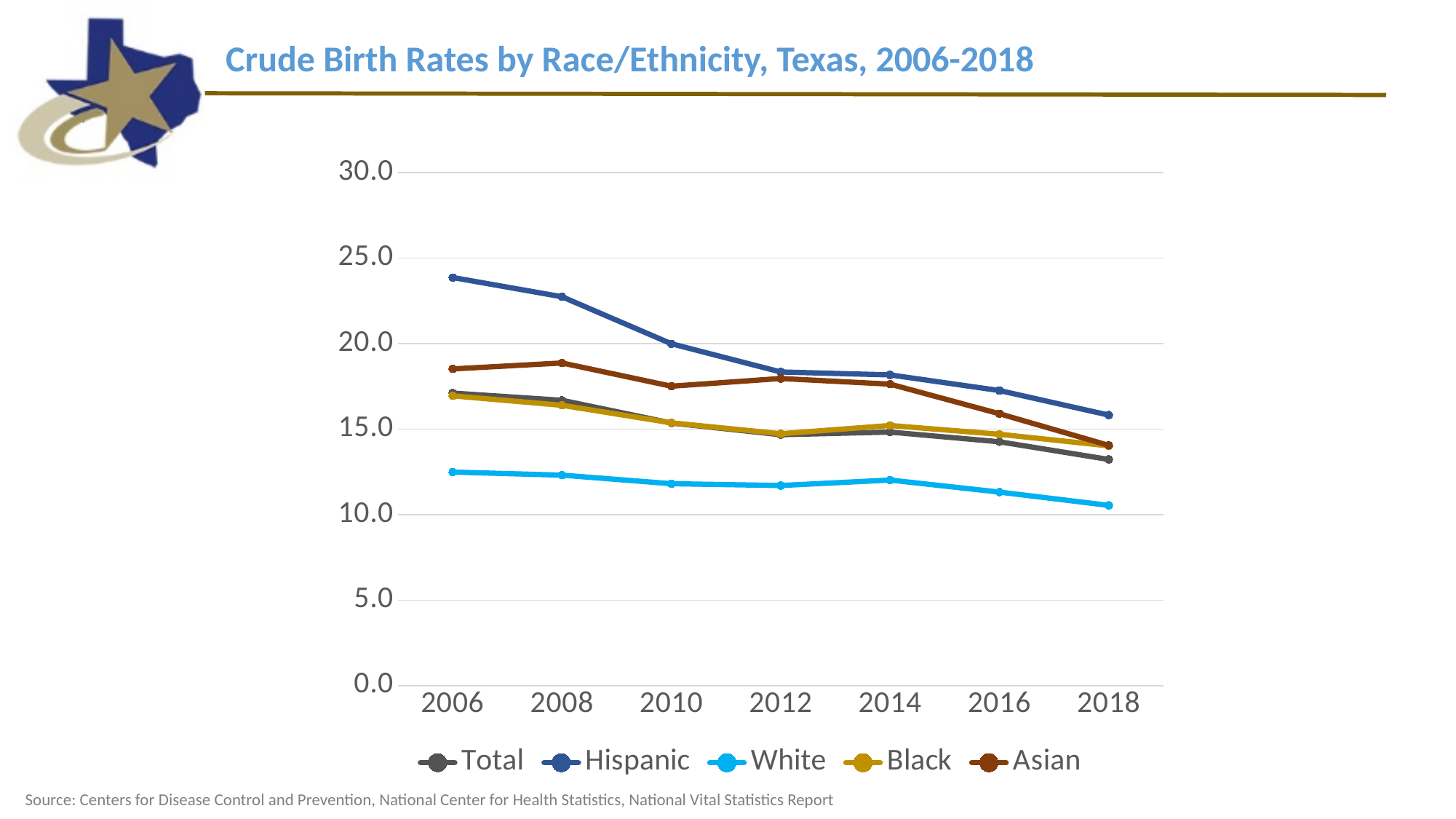
What kind of chart is shown on the slide? line chart Which race/ethnicity group has the lowest crude birth rate in 2018? White Is the Hispanic crude birth rate in 2018 greater or less than 20.0? less Which race/ethnicity group has the highest crude birth rate in 2006? Hispanic Is the Total crude birth rate in 2018 greater or less than 15.0? less Is the Hispanic crude birth rate in 2006 greater or less than 20.0? greater How many years are plotted along the x axis? 7 What is the title of the chart? Crude Birth Rates by Race/Ethnicity, Texas, 2006-2018 Does the Hispanic crude birth rate rise or fall from 2006 to 2018? fall In 2016, which is higher: the Hispanic or the Asian crude birth rate? Hispanic How many series does the legend list? 5